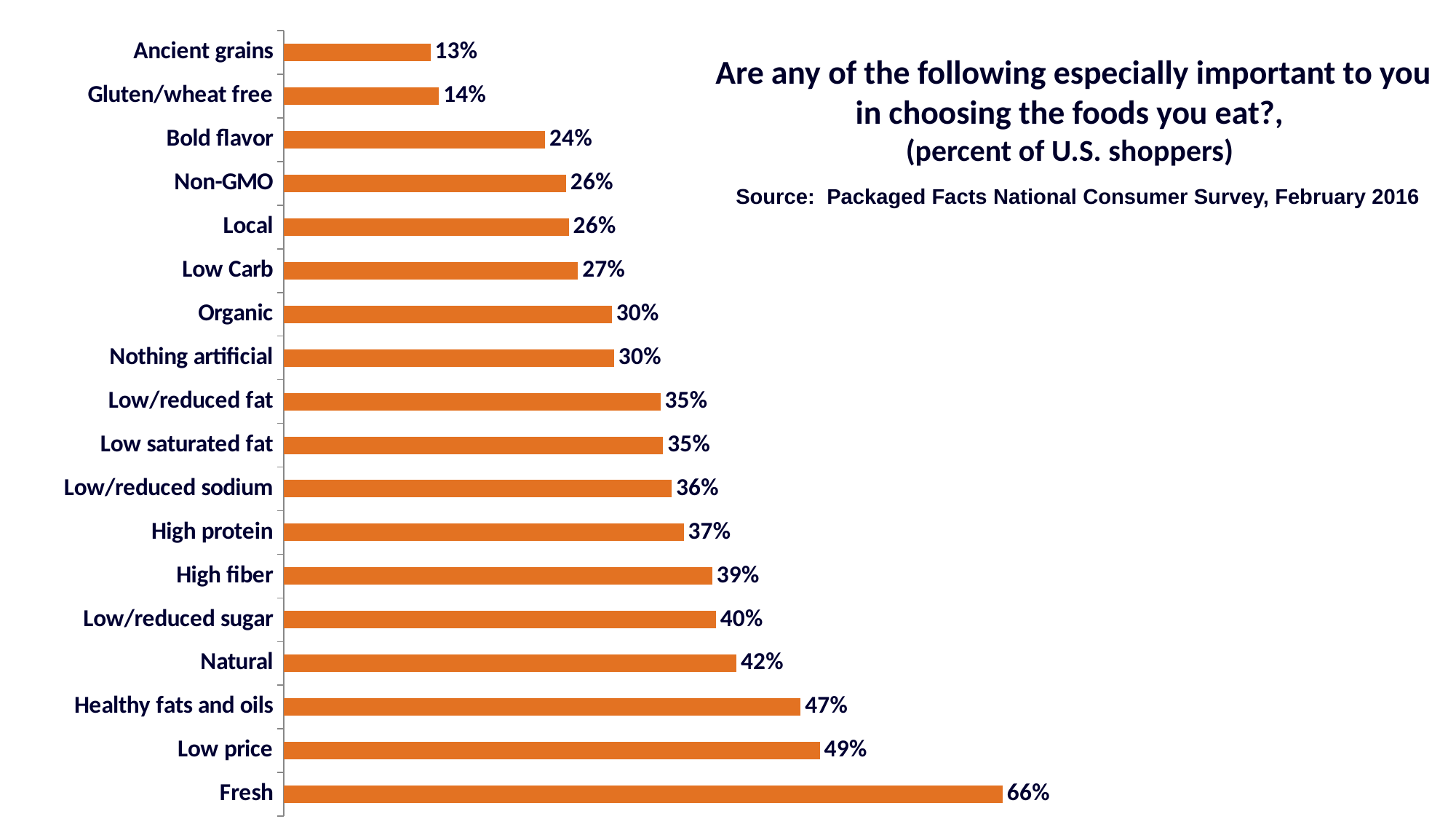
Which category has the highest value on the chart? Fresh What is the value shown for Non-GMO? 26% What percentage is shown for Healthy fats and oils? 47% Which has a larger value, Gluten/wheat free or Bold flavor? Bold flavor Which has a larger value, High fiber or Low Carb? High fiber What is the difference between the values for Fresh and Low price? 17% What kind of chart is shown on the slide? Bar chart What is the difference between the values for Natural and Organic? 12% According to the chart title, what is the source of the data? Packaged Facts National Consumer Survey, February 2016 How many categories are shown on the chart? 18 What percentage of U.S. shoppers said Fresh is especially important in choosing the foods they eat? 66% Which category has the lowest value on the chart? Ancient grains